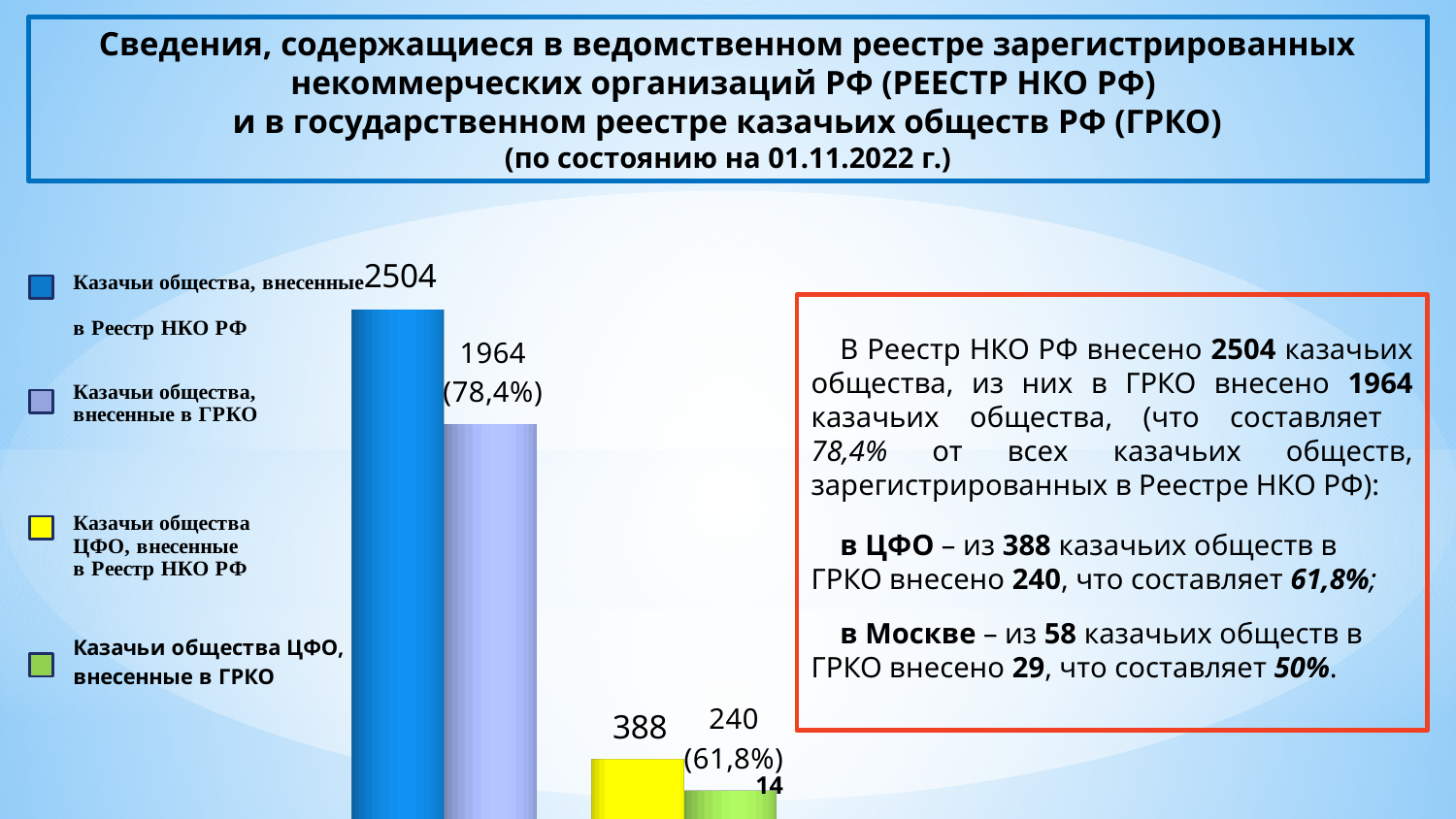
What is the value of the bar for Казачьи общества, внесенные в Реестр НКО РФ? 2504 What is the value of the bar for Казачьи общества, внесенные в ГРКО? 1964 What is the difference between the bar for Казачьи общества ЦФО, внесенные в Реестр НКО РФ and the bar for Казачьи общества ЦФО, внесенные в ГРКО? 148 Which legend category has the lowest bar in the chart? Казачьи общества ЦФО, внесенные в ГРКО What is the value of the bar for Казачьи общества ЦФО, внесенные в Реестр НКО РФ? 388 What is the value of the bar for Казачьи общества ЦФО, внесенные в ГРКО? 240 Which is larger: the bar for Казачьи общества, внесенные в ГРКО or the bar for Казачьи общества ЦФО, внесенные в Реестр НКО РФ? Казачьи общества, внесенные в ГРКО What type of chart is shown on the slide? bar chart Which legend category has the highest bar in the chart? Казачьи общества, внесенные в Реестр НКО РФ What is the difference between the bar for Казачьи общества, внесенные в Реестр НКО РФ and the bar for Казачьи общества, внесенные в ГРКО? 540 How many entries does the chart legend list? 4 How many bars are plotted in the chart? 4